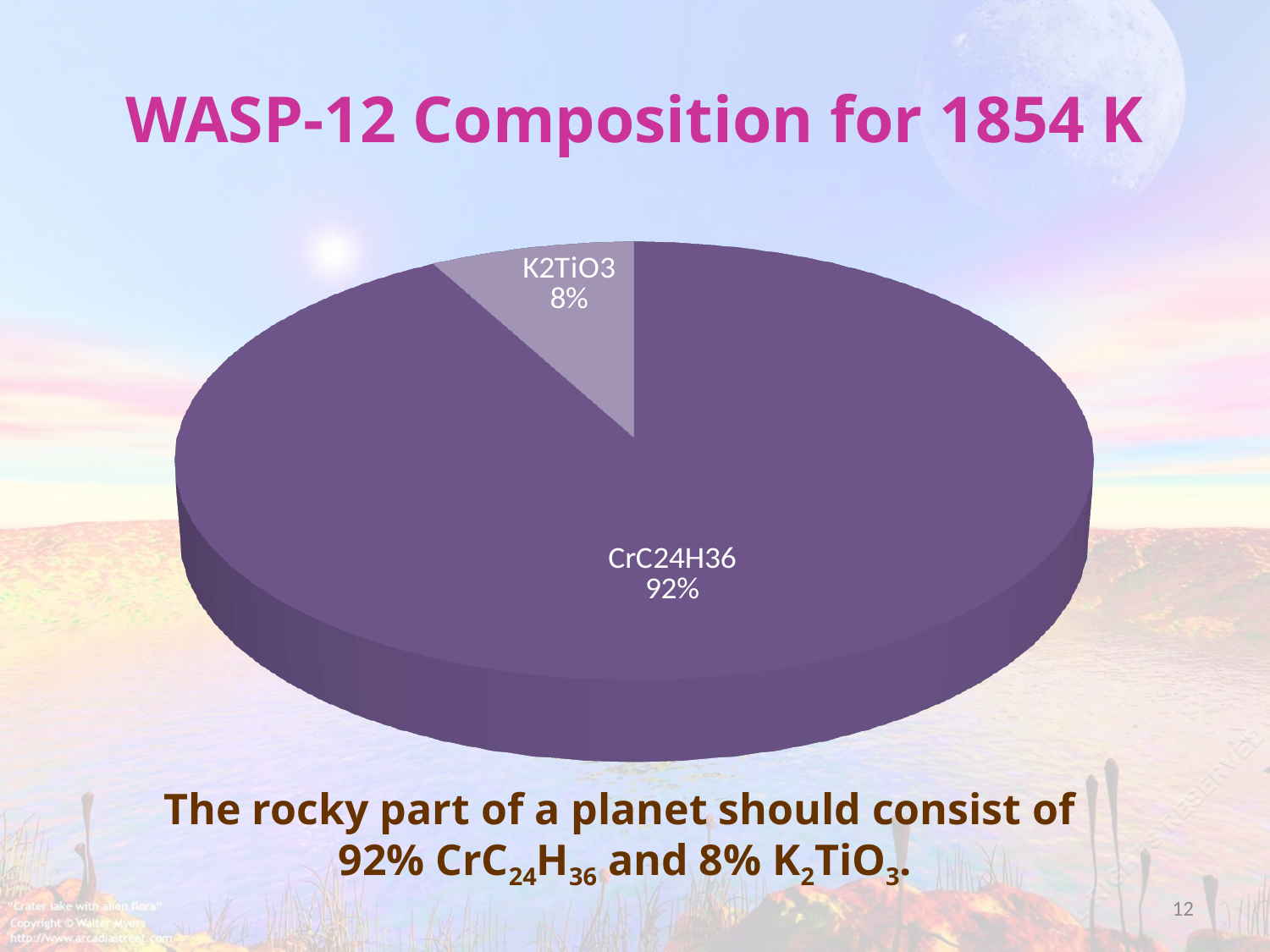
What share of the pie does K2TiO3 take? 8% How many slices does the pie chart have? 2 Which slice is the largest in the pie chart? CrC24H36 Which slice is shown in the lighter purple colour? K2TiO3 What kind of chart is shown on the slide? Pie chart What is the difference in percentage points between the CrC24H36 slice and the K2TiO3 slice? 84 What is the title of the chart? WASP-12 Composition for 1854 K What share of the pie does CrC24H36 take? 92% Is the share for K2TiO3 greater or less than 10%? less Which is larger, the CrC24H36 slice or the K2TiO3 slice? CrC24H36 What is the total of the two slice percentages shown? 100% Which slice is the smallest in the pie chart? K2TiO3